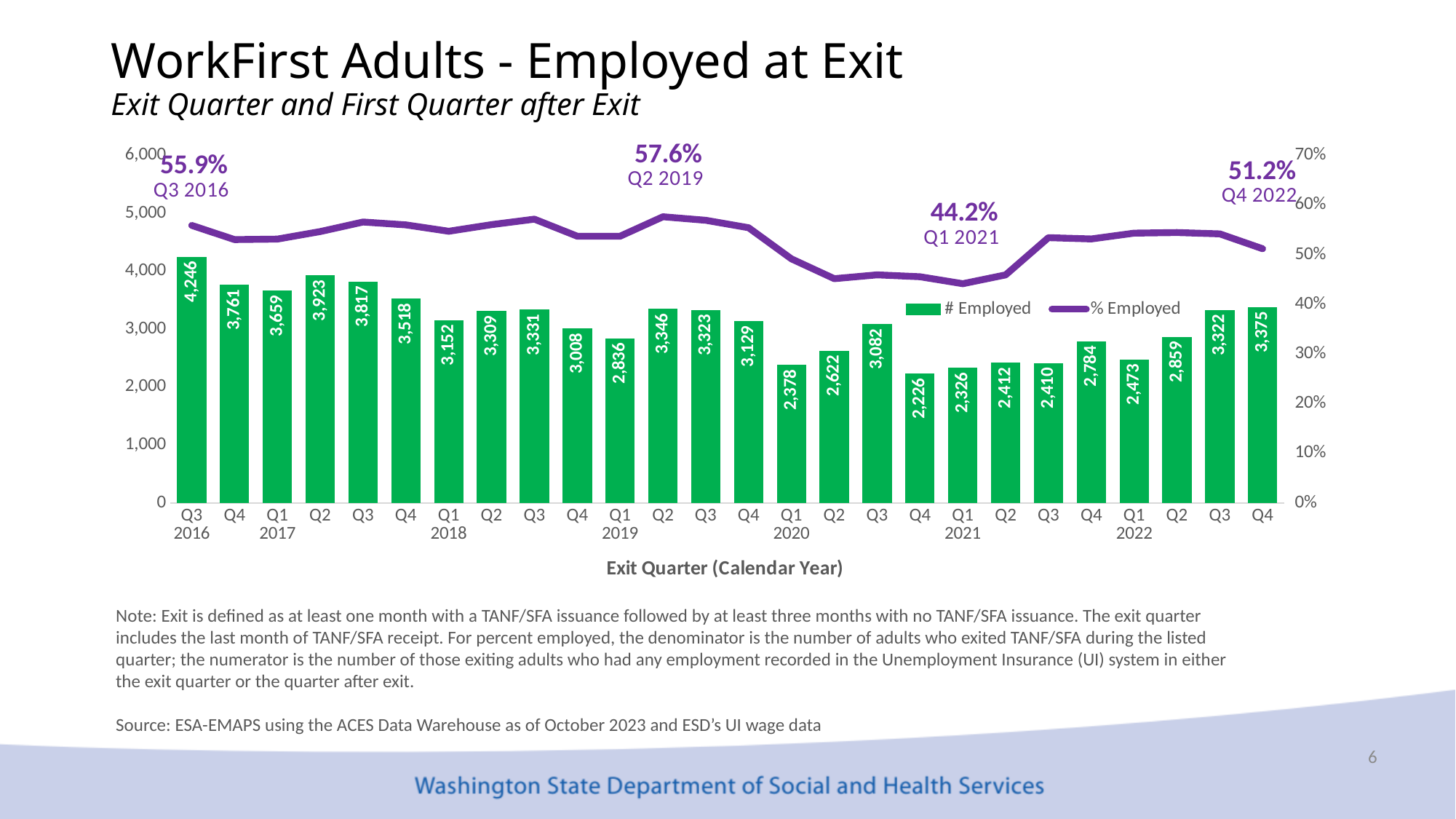
How many exit quarters are shown on the x axis? 26 How many adults were employed at exit in Q3 2016 according to the # Employed bars? 4,246 Which is larger, the # Employed for Q2 2017 or for Q3 2017? Q2 2017 What is the # Employed value for Q1 2020? 2,378 Which exit quarter has the highest # Employed bar? Q3 2016 What is the difference in # Employed between Q3 2016 and Q4 2022? 871 What percent employed is labeled for Q2 2019? 57.6% What is the x-axis title of the chart? Exit Quarter (Calendar Year) How many series does the legend list? 2 Which exit quarter has the lowest # Employed bar? Q4 2020 What is the # Employed value for Q4 2022? 3,375 What percent employed is labeled for Q1 2021? 44.2%